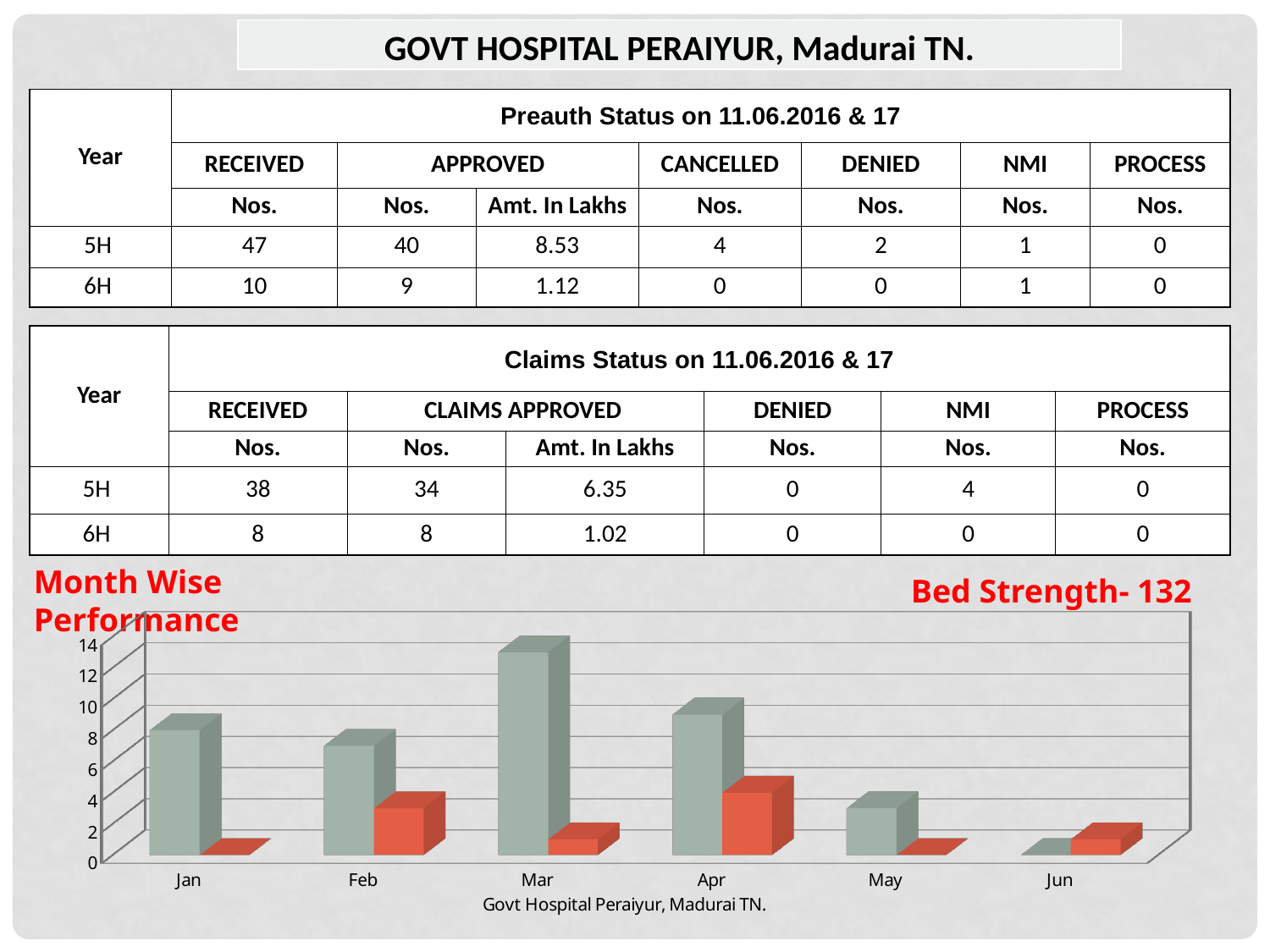
In the Month Wise Performance chart, do the grey bars rise or fall from Apr to Jun? fall How many months are shown on the x axis of the Month Wise Performance chart? 6 In the Month Wise Performance chart, is the orange bar for Apr greater or less than 2? greater In the Month Wise Performance chart, which month has the tallest grey bar? Mar In the Month Wise Performance chart, which grey bar is taller, Mar or Apr? Mar In the Month Wise Performance chart, which grey bar is taller, Apr or May? Apr In the Month Wise Performance chart, is the grey bar for Mar greater or less than 10? greater In the Month Wise Performance chart, is the grey bar for Jan greater or less than 6? greater In the Month Wise Performance chart, which month has the lowest grey bar? Jun What kind of chart is shown at the bottom of the slide? bar chart What text appears below the x axis of the Month Wise Performance chart? Govt Hospital Peraiyur, Madurai TN.